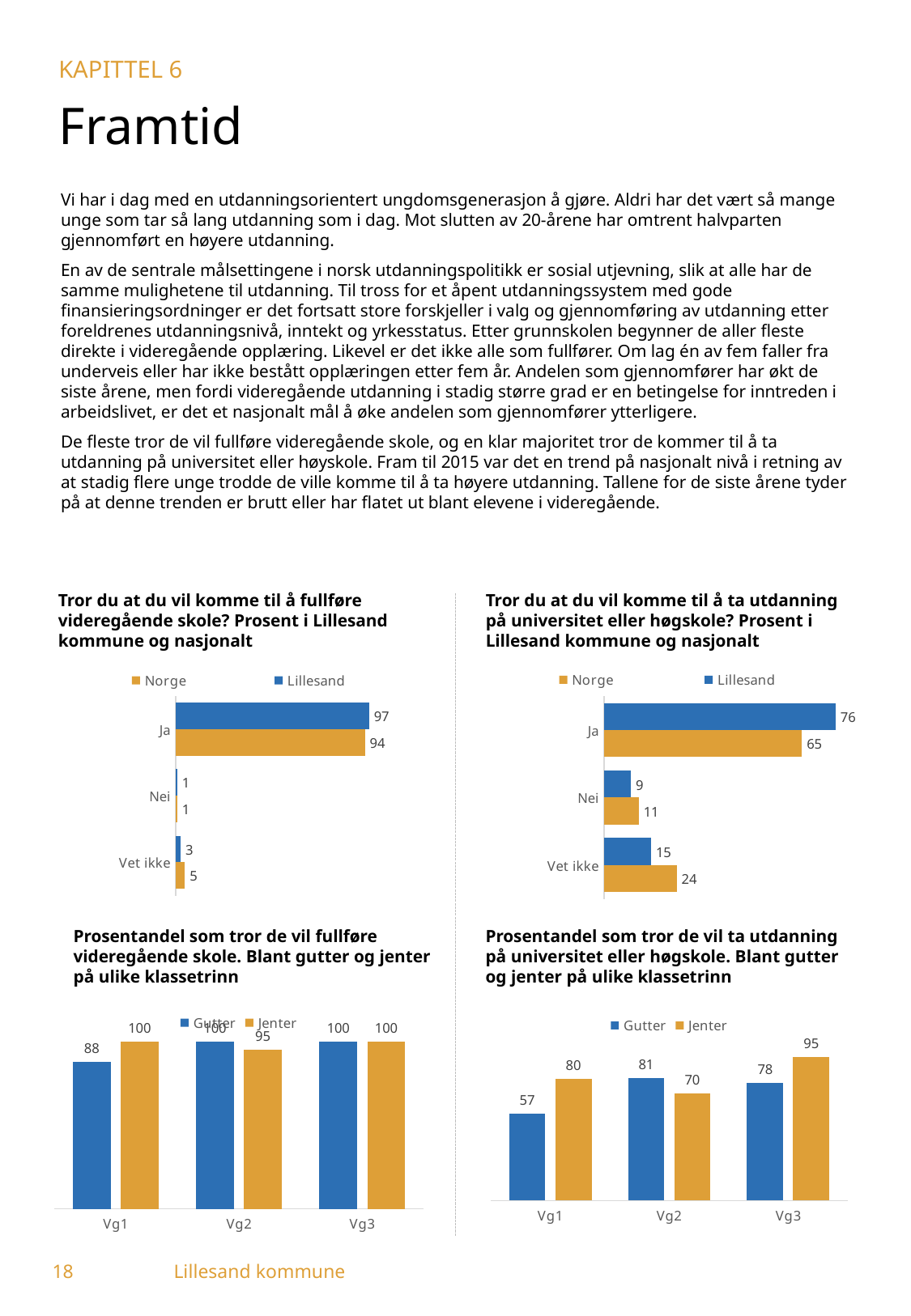
In the top-right chart (Tror du at du vil komme til å ta utdanning på universitet eller høgskole?), what is the value for Norge for 'Vet ikke'? 24 In the bottom-left chart (Prosentandel som tror de vil fullføre videregående skole), what is the value for Jenter at Vg2? 95 In the top-right chart (Tror du at du vil komme til å ta utdanning på universitet eller høgskole?), what is the difference between the Norge and Lillesand values for 'Nei'? 2 In the top-left chart (Tror du at du vil komme til å fullføre videregående skole?), what is the value for Norge for 'Vet ikke'? 5 In the bottom-left chart (Prosentandel som tror de vil fullføre videregående skole), what is the value for Gutter at Vg1? 88 In the bottom-right chart (Prosentandel som tror de vil ta utdanning på universitet eller høgskole), what is the difference between Jenter and Gutter at Vg3? 17 In the top-right chart (Tror du at du vil komme til å ta utdanning på universitet eller høgskole?), how many series does the legend list? 2 What kind of chart is the bottom-right chart (Prosentandel som tror de vil ta utdanning på universitet eller høgskole)? Bar chart In the top-left chart (Tror du at du vil komme til å fullføre videregående skole?), what is the difference between the Lillesand and Norge values for 'Ja'? 3 In the top-left chart (Tror du at du vil komme til å fullføre videregående skole?), what is the value for Lillesand for 'Ja'? 97 In the top-right chart (Tror du at du vil komme til å ta utdanning på universitet eller høgskole?), which is larger for 'Ja': Norge or Lillesand? Lillesand In the bottom-right chart (Prosentandel som tror de vil ta utdanning på universitet eller høgskole), which class level has the lowest value for Gutter? Vg1